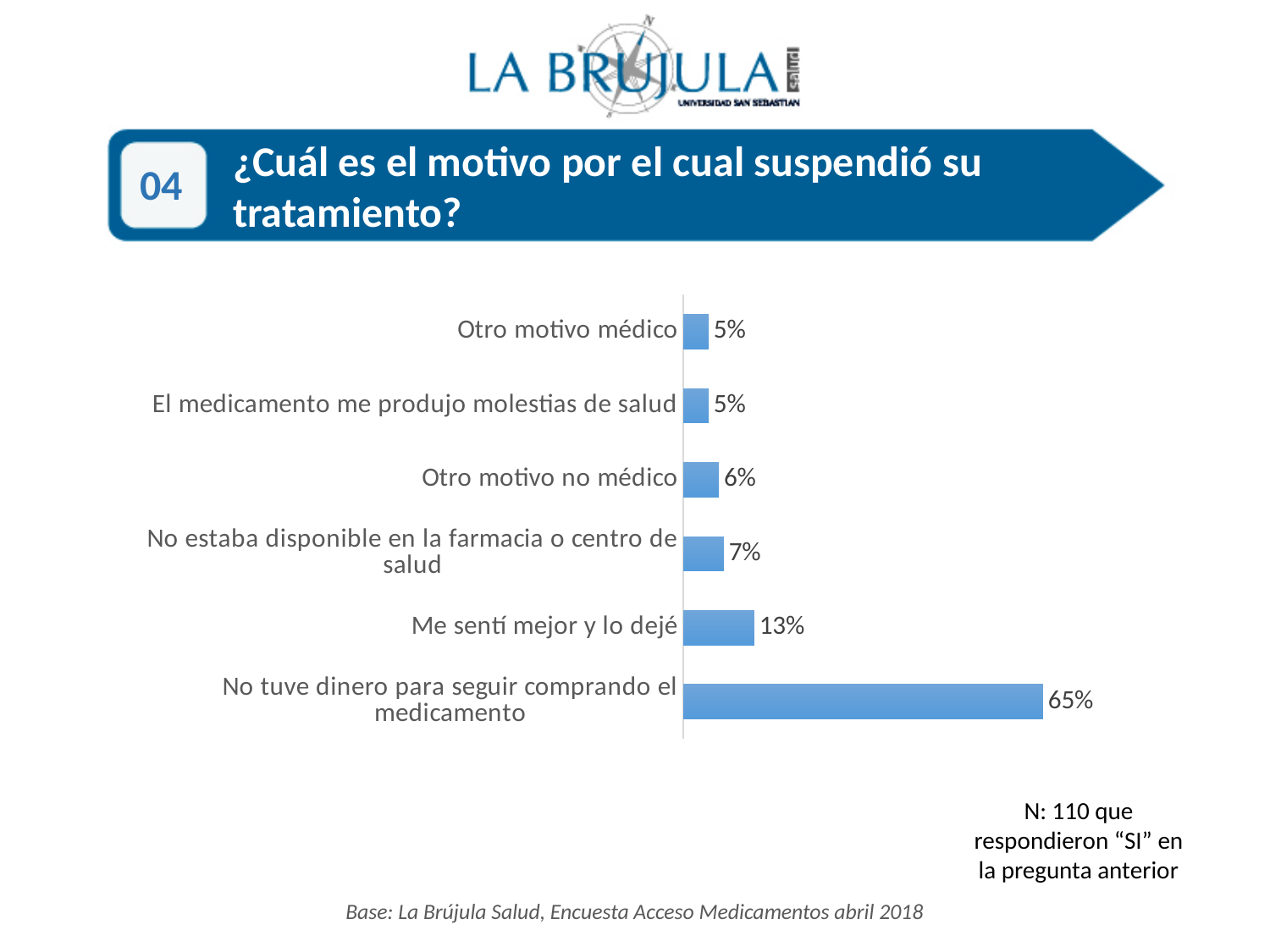
What type of chart is shown on the slide? Bar chart How many categories (reasons) are shown in the chart? 6 Which reason has the highest percentage? No tuve dinero para seguir comprando el medicamento What percentage of respondents said "No tuve dinero para seguir comprando el medicamento"? 65% Which is larger: the value for "Otro motivo no médico" or the value for "No estaba disponible en la farmacia o centro de salud"? No estaba disponible en la farmacia o centro de salud What is the value for "No estaba disponible en la farmacia o centro de salud"? 7% What is the value for "El medicamento me produjo molestias de salud"? 5% What is the difference in percentage points between "No tuve dinero para seguir comprando el medicamento" and "Me sentí mejor y lo dejé"? 52 What is the value for "Otro motivo no médico"? 6% How many categories share the lowest value of 5%? 2 What is the question shown in the slide's title banner? ¿Cuál es el motivo por el cual suspendió su tratamiento? What is the value for "Me sentí mejor y lo dejé"? 13%